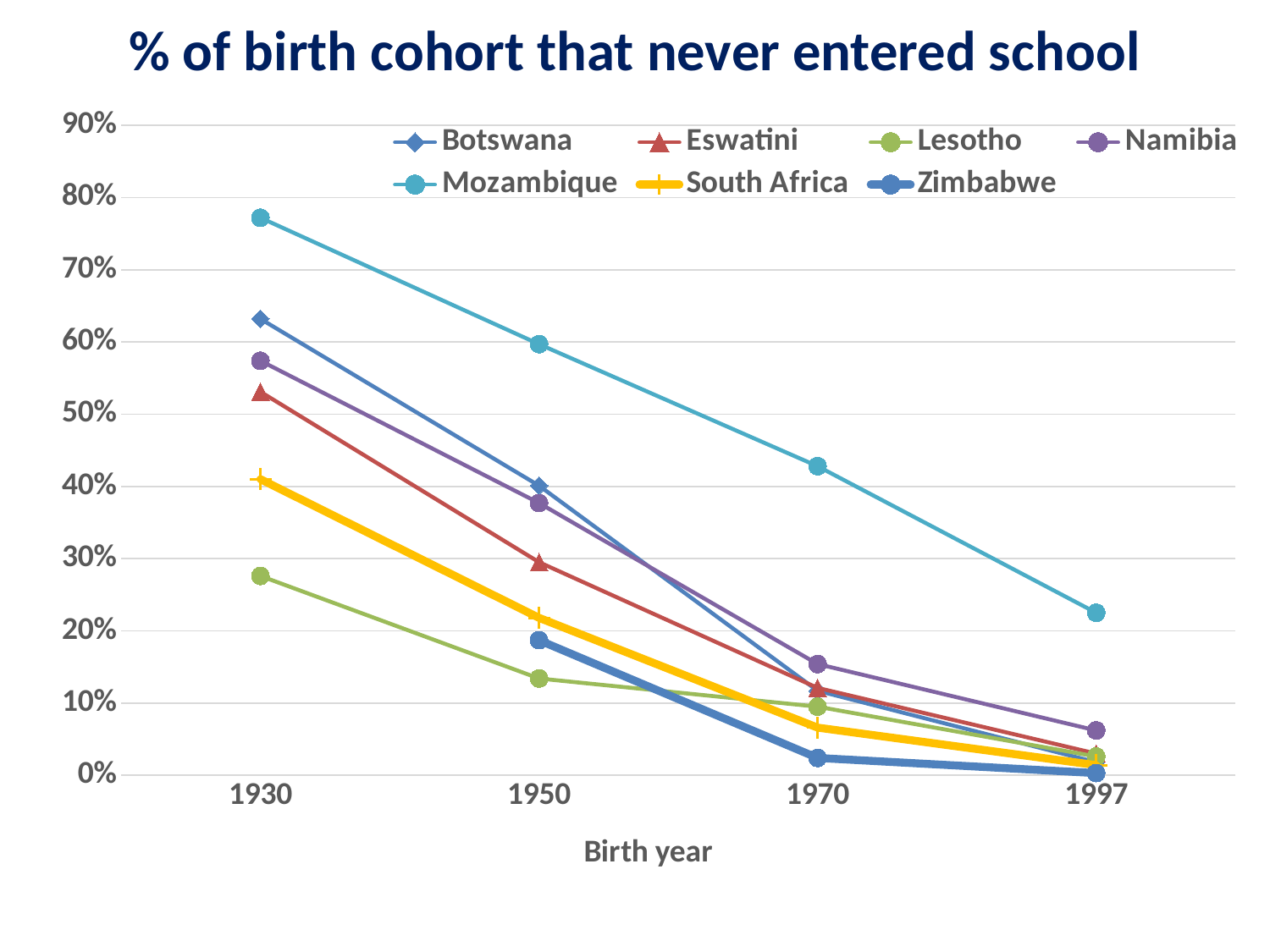
What is the title of the x axis? Birth year Is the value for Namibia in 1970 greater or less than 20%? less How many series does the legend list? 7 Do the values for Mozambique rise or fall from 1930 to 1997? fall Which country has the lowest value for the 1930 birth cohort? Lesotho Is the value for Botswana in 1950 greater or less than 50%? less Which is larger for the 1997 birth cohort, Mozambique or Namibia? Mozambique How many birth years are shown on the x axis? 4 What kind of chart is shown on the slide? line chart Is the value for Mozambique in 1930 greater or less than 70%? greater Which country has the highest value for the 1930 birth cohort? Mozambique Which country has the highest value for the 1997 birth cohort? Mozambique